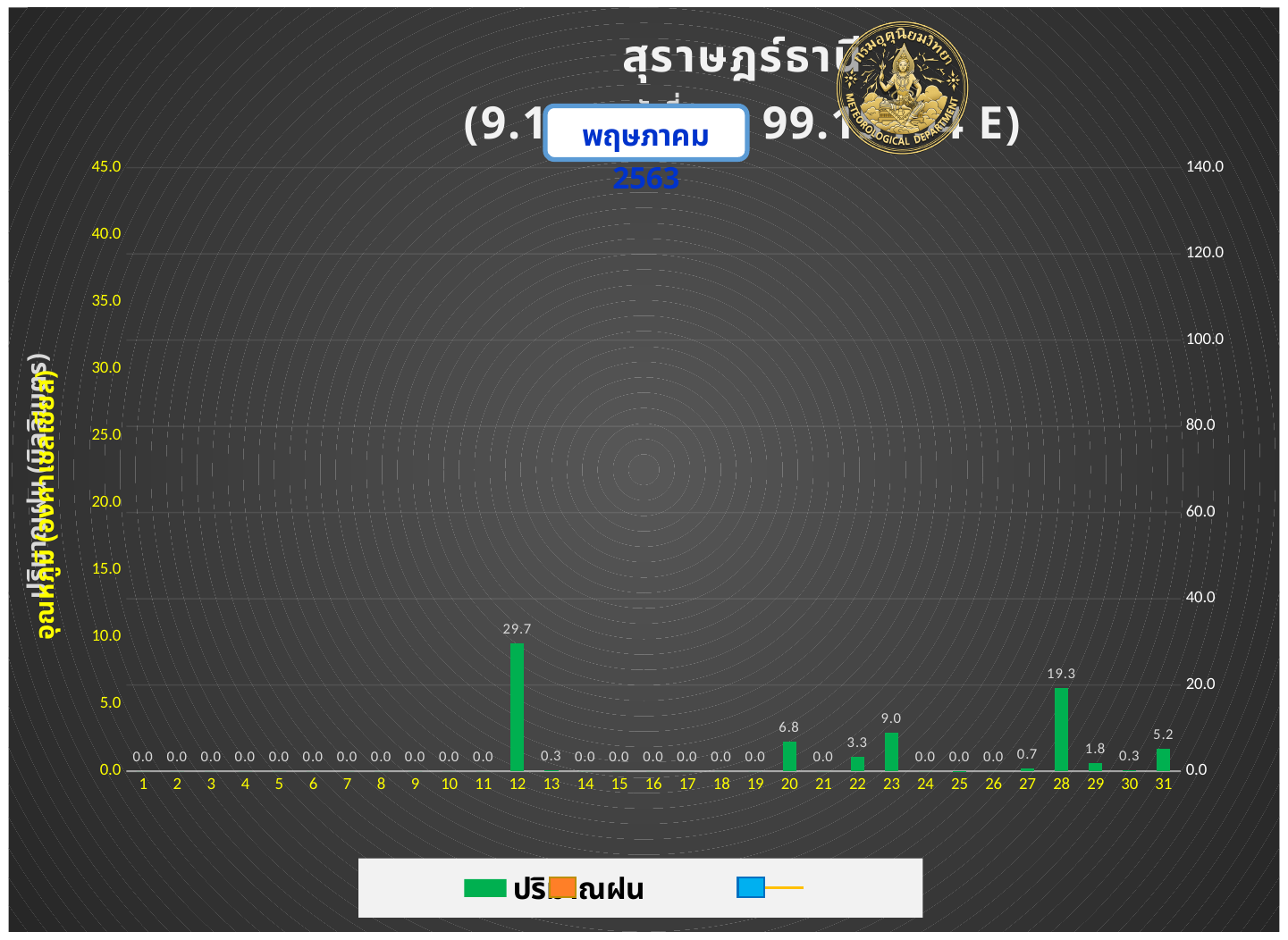
What is the rainfall value shown for day 23? 9.0 How many days (categories) are shown on the x axis? 31 What is the rainfall value shown for day 28? 19.3 Which day has the highest rainfall value? 12 What is the difference between the rainfall values for day 29 and day 30? 1.5 What is the rainfall value shown for day 20? 6.8 What is the rainfall value shown for day 12? 29.7 What colour are the rainfall (ปริมาณฝน) bars? green Which is larger, the rainfall value for day 23 or for day 20? day 23 What kind of chart is shown on the slide? bar chart What is the rainfall value shown for day 31? 5.2 What is the difference between the rainfall values for day 12 and day 28? 10.4